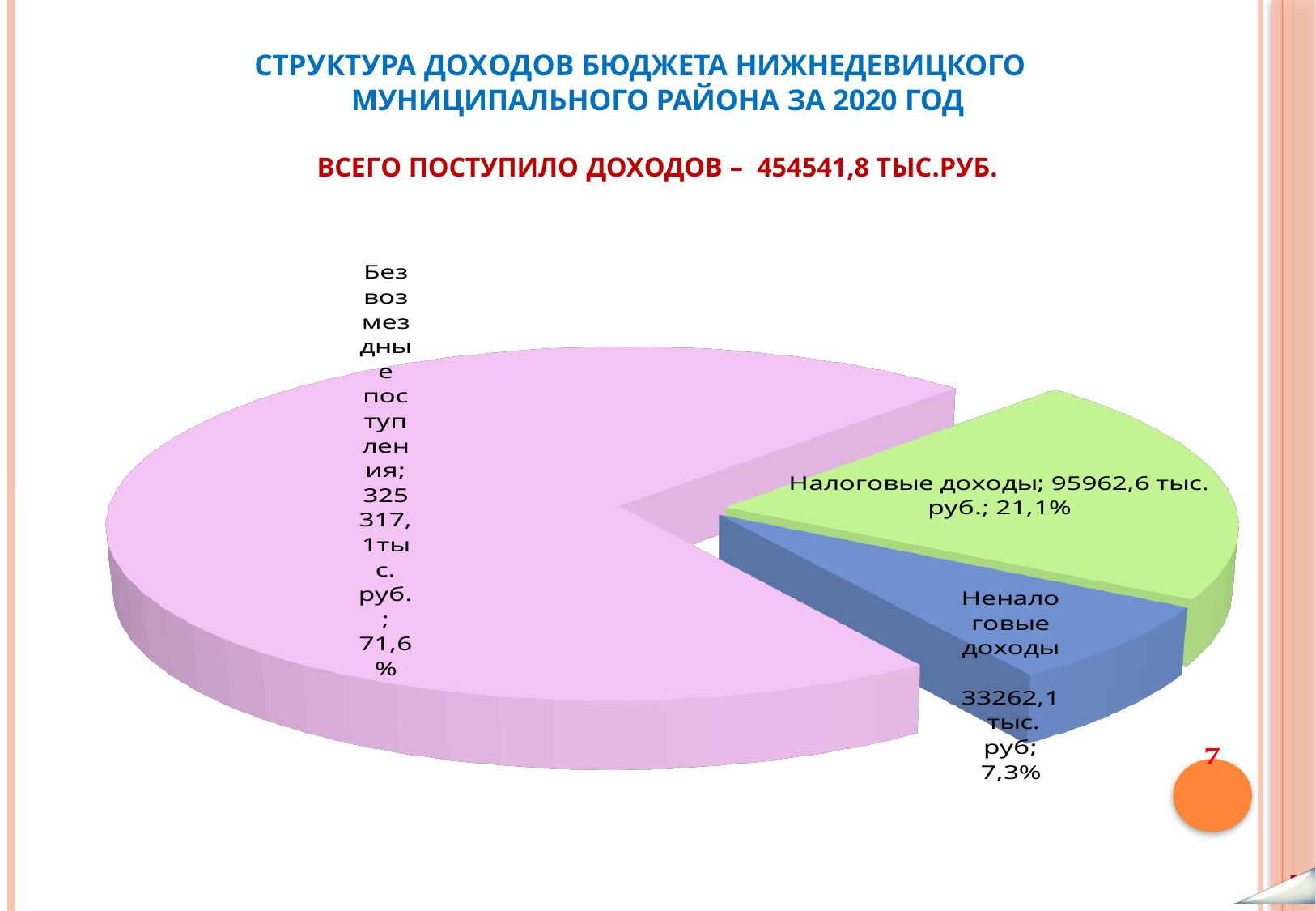
What is the difference in тыс. руб. between Налоговые доходы and Неналоговые доходы? 62700,5 How many slices does the pie chart have? 3 What percentage share is shown for Неналоговые доходы? 7,3% Which slice of the pie chart is the largest? Безвозмездные поступления What percentage share is shown for Налоговые доходы? 21,1% What colour is the slice for Неналоговые доходы? blue What is the value shown for Налоговые доходы? 95962,6 тыс. руб. What kind of chart is shown on the slide? pie chart Which is larger, Налоговые доходы or Неналоговые доходы? Налоговые доходы Which slice of the pie chart is the smallest? Неналоговые доходы What percentage share is shown for Безвозмездные поступления? 71,6% What is the value shown for Безвозмездные поступления? 325317,1 тыс. руб.